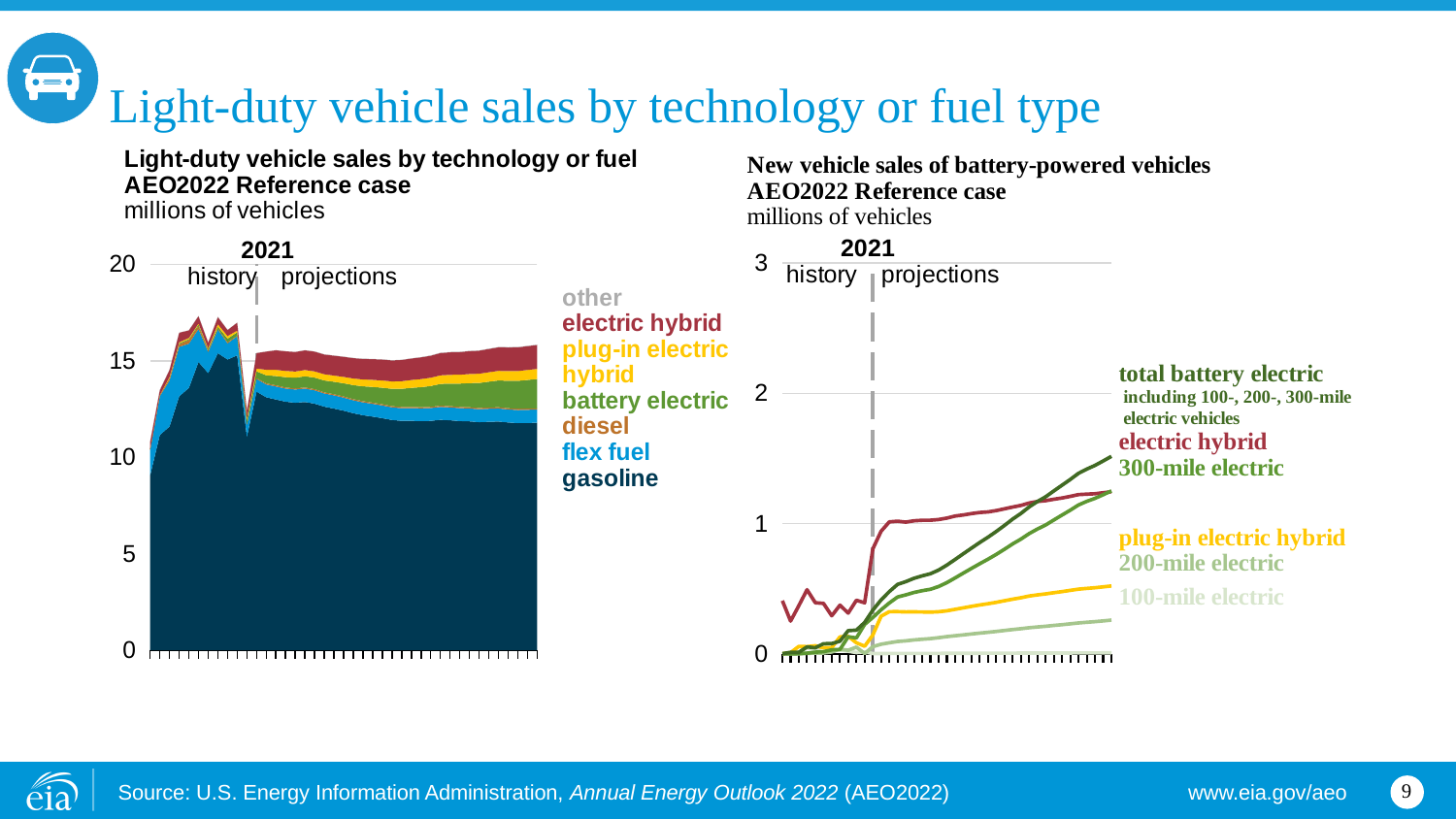
In the right chart, 'New vehicle sales of battery-powered vehicles', is the value for plug-in electric hybrid at the end of the projection period greater or less than 1? less In the left chart, 'Light-duty vehicle sales by technology or fuel', which series occupies the largest area of the stack? gasoline In the right chart, 'New vehicle sales of battery-powered vehicles', is the value for 100-mile electric at the end of the projection period greater or less than 1? less What kind of chart is the right chart, 'New vehicle sales of battery-powered vehicles'? line chart In the right chart, 'New vehicle sales of battery-powered vehicles', which is higher at the end of the projection period: total battery electric or 100-mile electric? total battery electric How many series does the legend of the left chart, 'Light-duty vehicle sales by technology or fuel', list? 7 What kind of chart is the left chart, 'Light-duty vehicle sales by technology or fuel'? stacked area chart In the left chart, 'Light-duty vehicle sales by technology or fuel', is the total stacked value at the end of the projection period greater or less than 15? greater How many series are labelled on the right chart, 'New vehicle sales of battery-powered vehicles'? 6 In the right chart, 'New vehicle sales of battery-powered vehicles', does the total battery electric line rise or fall over the projection period? rise What year does the dashed vertical line separating history from projections mark on both charts? 2021